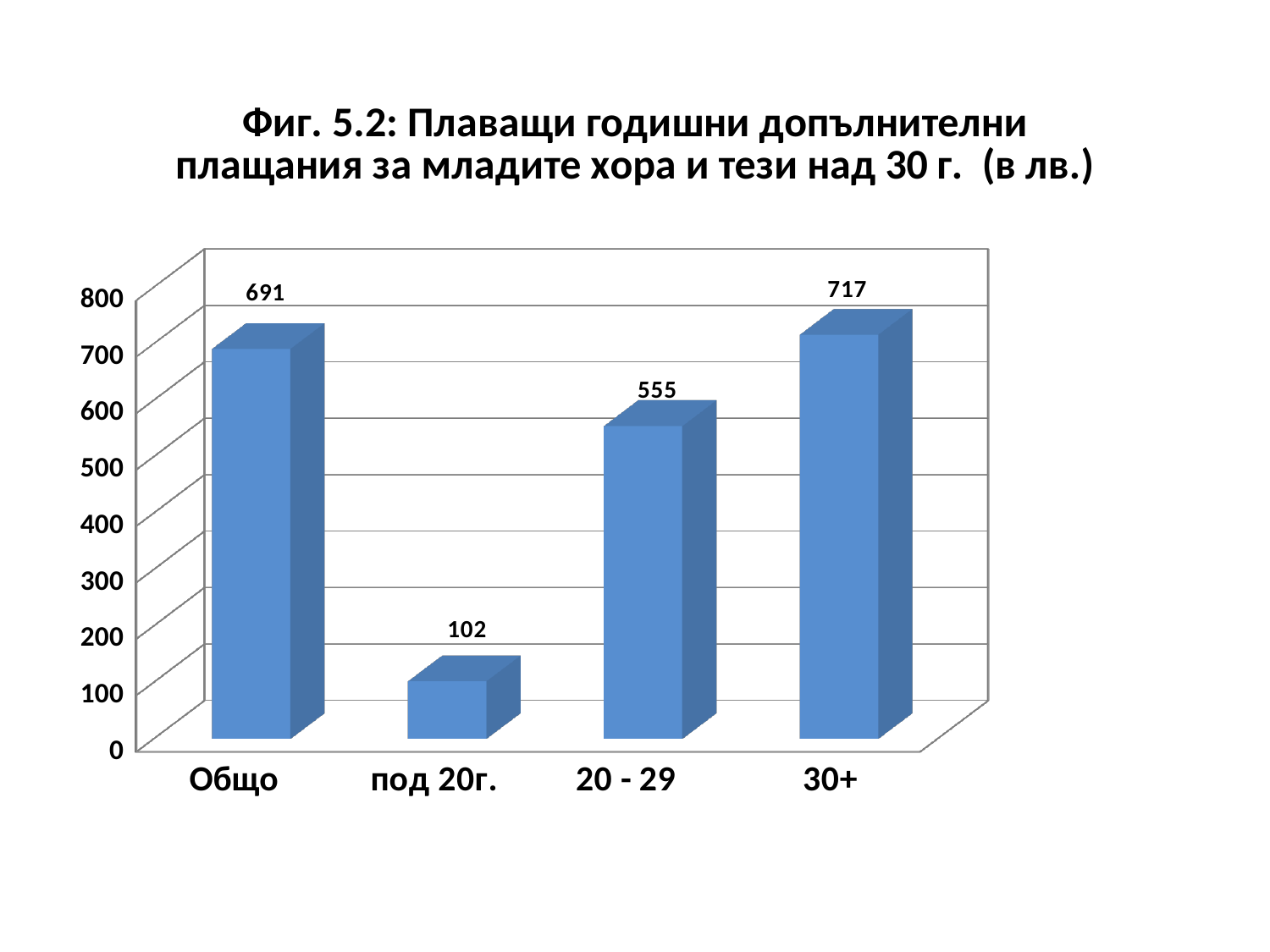
What is the figure number given in the chart title? Фиг. 5.2 What is the difference between the values for Общо and под 20г.? 589 Which is larger, the value for Общо or the value for 20 - 29? Общо What is the value for 20 - 29? 555 Which category has the lowest value? под 20г. What is the value for 30+? 717 How many categories are shown on the x axis? 4 What kind of chart is shown on the slide? bar chart What is the difference between the values for 30+ and 20 - 29? 162 Which category has the highest value? 30+ What is the value for под 20г.? 102 What is the value for Общо? 691